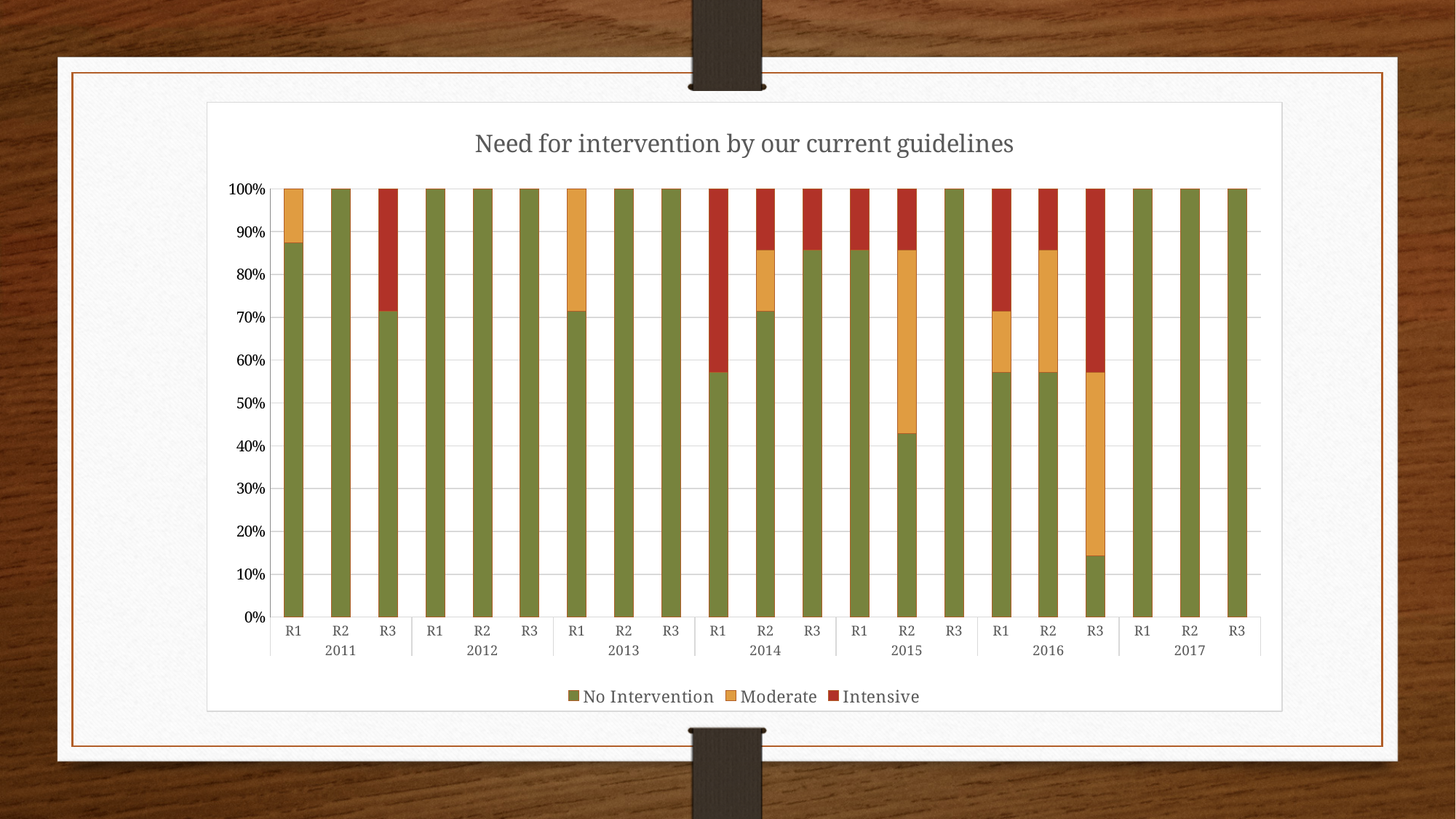
Is the No Intervention value for 2016 R3 greater or less than 20%? less How many series does the legend list? 3 What are the three series named in the legend? No Intervention, Moderate, Intensive What is the total of the stacked bar for 2015 R2? 100% How many bars are plotted in the chart? 21 Which bar has the lowest No Intervention share? 2016 R3 What type of chart is shown on the slide? Stacked bar chart Is the No Intervention value for 2014 R1 greater or less than 50%? greater What is the title of the chart? Need for intervention by our current guidelines How many years are shown along the x axis? 7 Which has the larger No Intervention share, 2015 R2 or 2016 R3? 2015 R2 Is the No Intervention value for 2011 R1 greater or less than 80%? greater